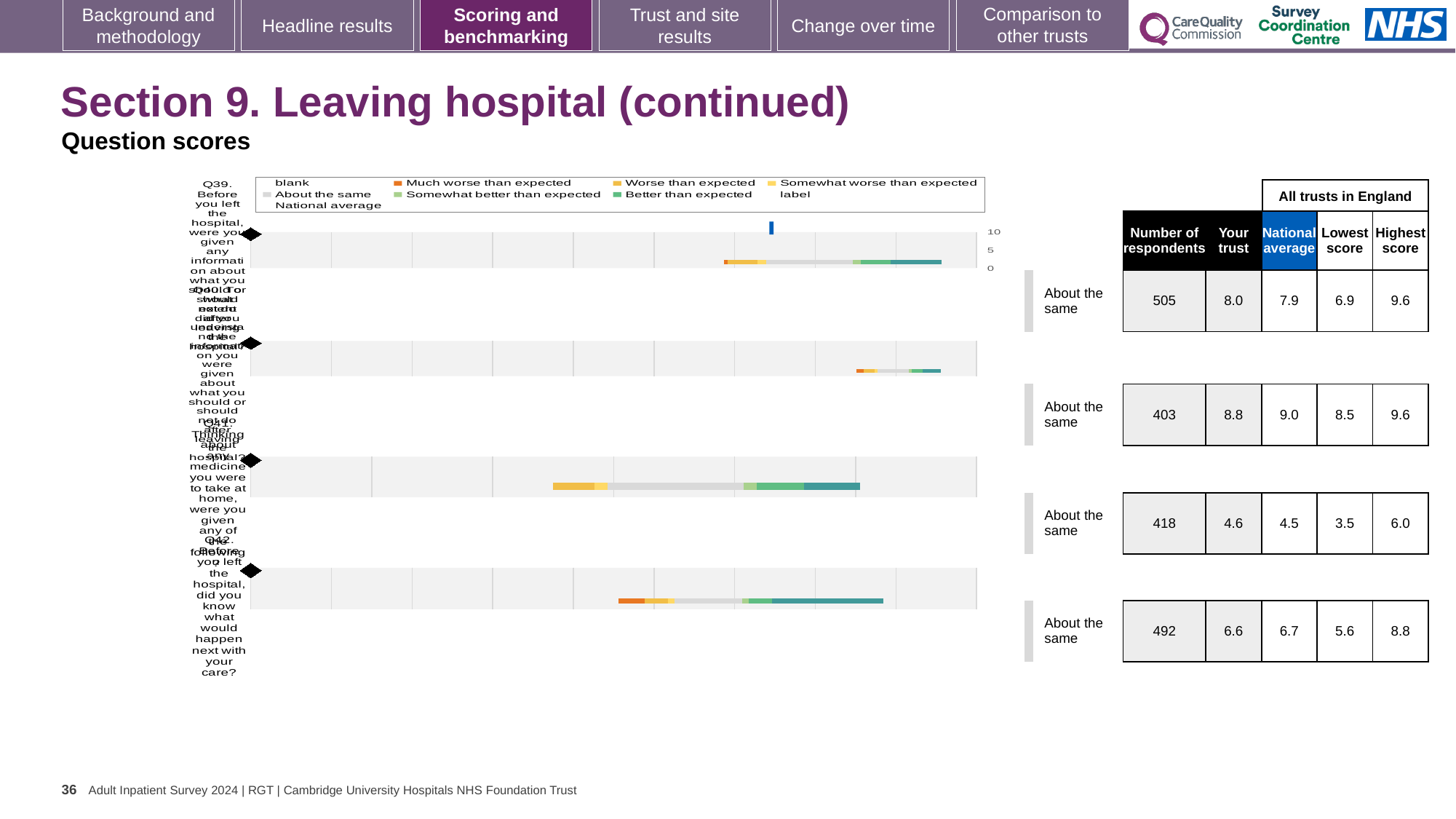
For Q42 (the bottom row), which is larger: the 'Your trust' score or the national average? National average What kind of chart is used to show the question scores on this slide? bar chart What is the number of respondents for the first (top) question row? 505 What is the lowest score among all trusts in England for the second question row? 8.5 Which question row has the lowest 'Your trust' score? the third row (4.6) What benchmark category is shown for all four question rows? About the same What is the national average for the third question row? 4.5 For the third question row, what is the difference between the highest score and the lowest score? 2.5 How many question rows are plotted in the chart? 4 What is the 'Your trust' score for the second question row? 8.8 Which question row has the highest 'Your trust' score? the second row (8.8) What is the highest score among all trusts in England for Q42 (the bottom row)? 8.8